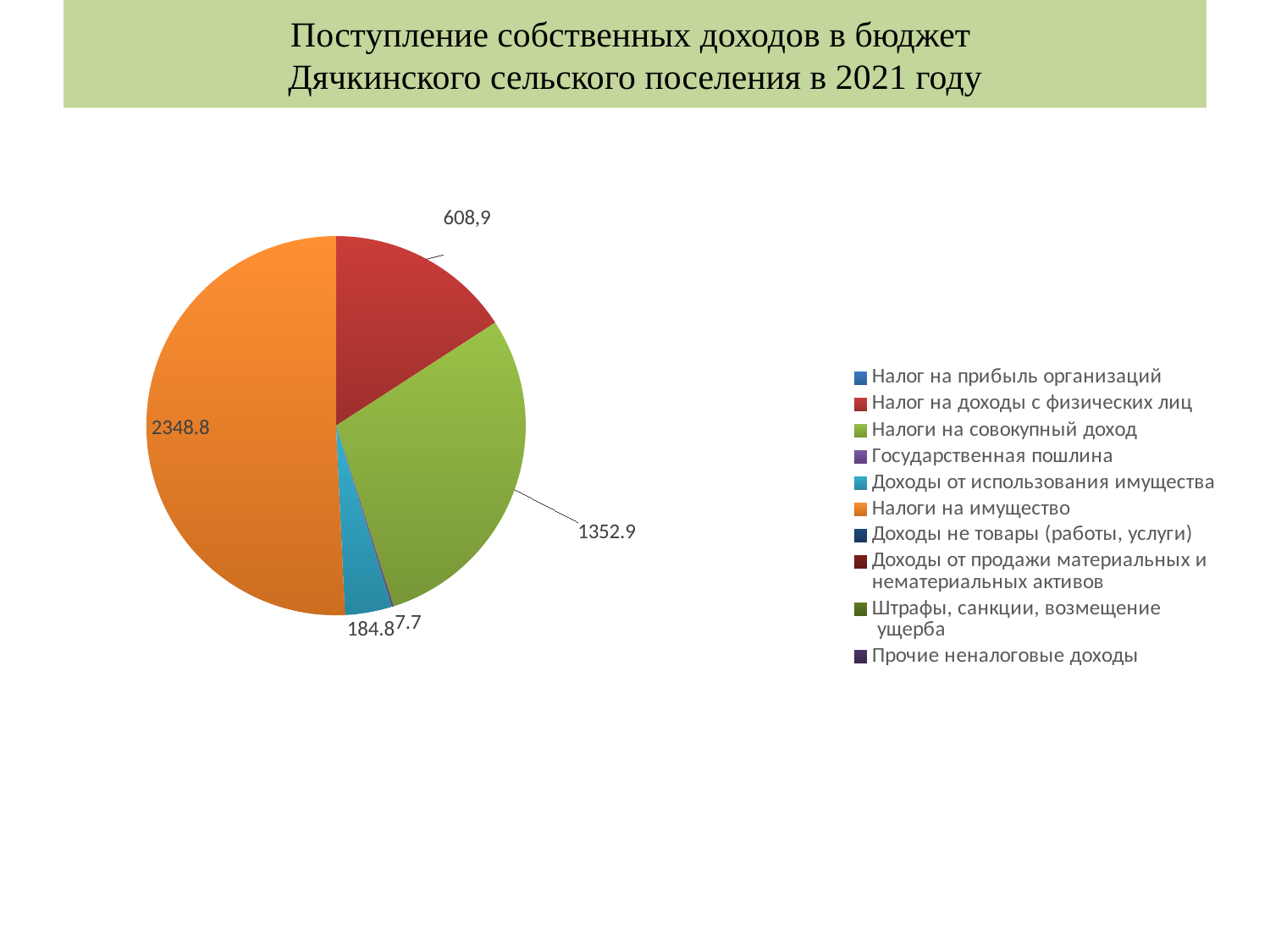
What colour is the slice for Налоги на имущество? orange How many entries does the legend list? 10 What is the value for Налоги на совокупный доход? 1352.9 What is the value for Налоги на имущество? 2348.8 What is the difference between the values for Налоги на имущество and Налоги на совокупный доход? 995.9 What is the difference between the values for Налог на доходы с физических лиц and Доходы от использования имущества? 424.1 What is the title of the slide? Поступление собственных доходов в бюджет Дячкинского сельского поселения в 2021 году What is the value for Доходы от использования имущества? 184.8 What is the value for Налог на доходы с физических лиц? 608,9 Which category has the largest slice of the pie? Налоги на имущество What kind of chart is shown on the slide? pie chart Which is larger, Налоги на совокупный доход or Налог на доходы с физических лиц? Налоги на совокупный доход